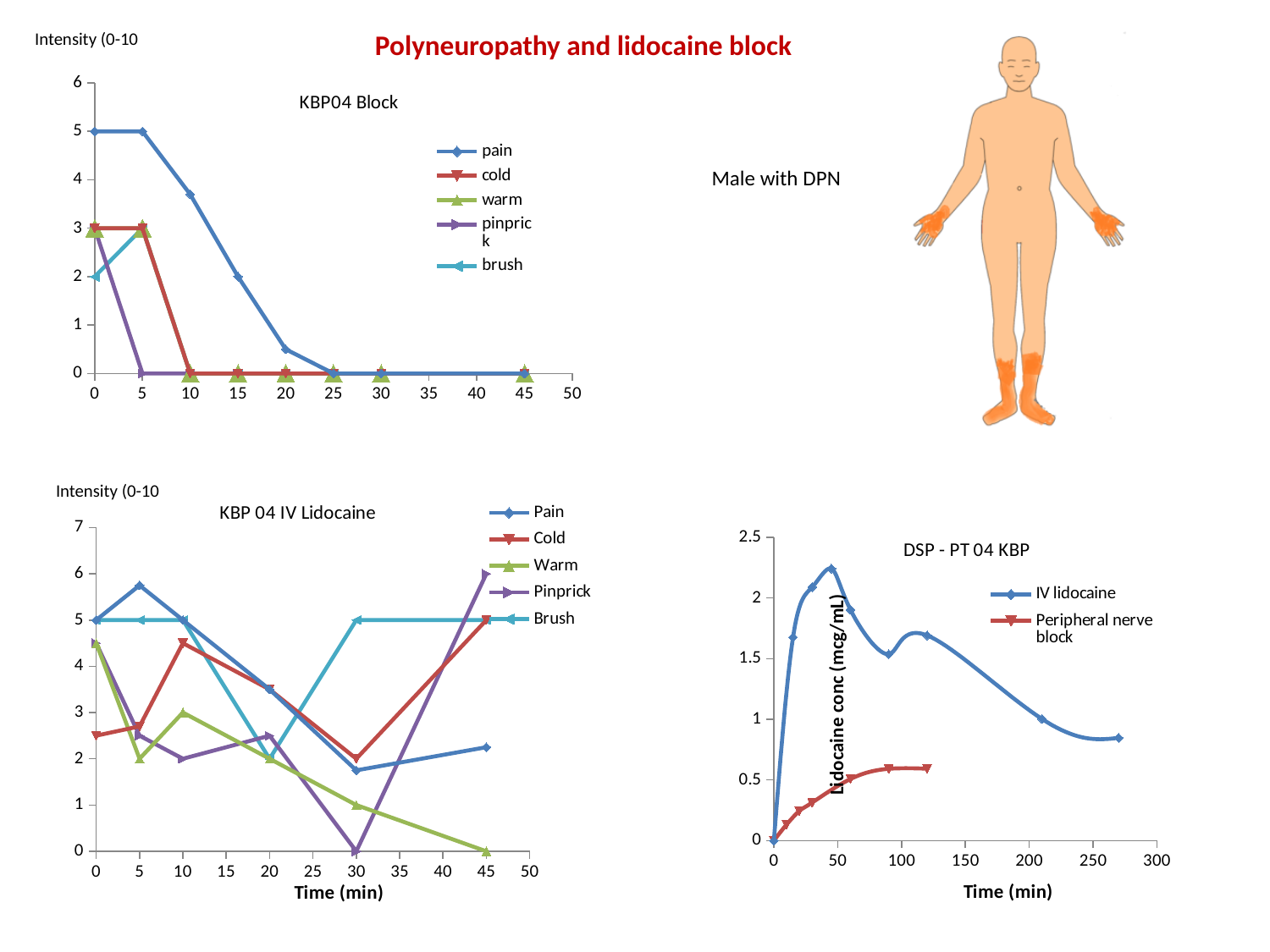
In the KBP04 Block chart, what is the pinprick intensity at 5 minutes? 0 In the KBP04 Block chart, what is the pain intensity at 0 minutes? 5 How many series does the legend of the KBP04 Block chart list? 5 In the DSP - PT 04 KBP chart, is the peak IV lidocaine concentration greater or less than 2? greater In the KBP04 Block chart, what is the brush intensity at 0 minutes? 2 In the KBP 04 IV Lidocaine chart, what is the Warm intensity at 45 minutes? 0 In the KBP 04 IV Lidocaine chart, what is the Pinprick intensity at 45 minutes? 6 In the KBP04 Block chart, does the pain series rise or fall over time? fall In the DSP - PT 04 KBP chart, which series reaches a higher concentration, IV lidocaine or Peripheral nerve block? IV lidocaine What kind of chart is the DSP - PT 04 KBP chart? line chart In the KBP 04 IV Lidocaine chart, which series has the highest value at 45 minutes? Pinprick In the KBP04 Block chart, is the pain value at 10 minutes greater or less than 3? greater